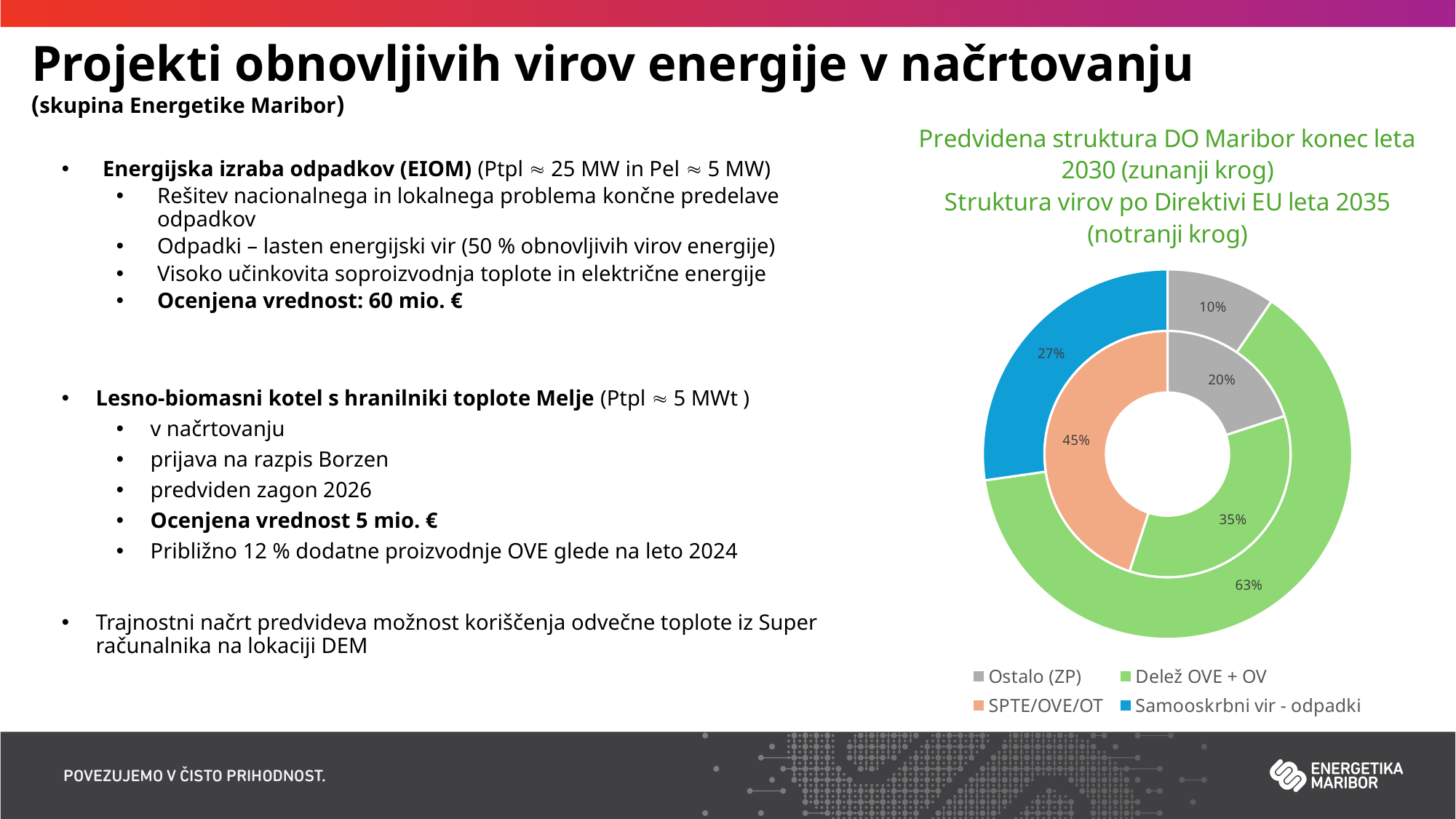
What kind of chart is shown on the right side of the slide? doughnut chart How many entries does the chart legend list? 4 In the outer ring (2030), what share is labelled for Ostalo (ZP)? 10% Which category has the smallest share in the inner ring (2035)? Ostalo (ZP) Which category has the largest share in the outer ring (2030)? Delež OVE + OV In the outer ring (2030), what share is labelled for Delež OVE + OV? 63% In the inner ring (2035), what share is labelled for Delež OVE + OV? 35% What is the difference between the Delež OVE + OV share in the outer ring (63%) and in the inner ring (35%)? 28% Which colour represents Samooskrbni vir - odpadki in the chart? blue In the outer ring (2030), what share is labelled for Samooskrbni vir - odpadki? 27% In the inner ring (2035), what share is labelled for Ostalo (ZP)? 20% In the inner ring (2035), what share is labelled for SPTE/OVE/OT? 45%